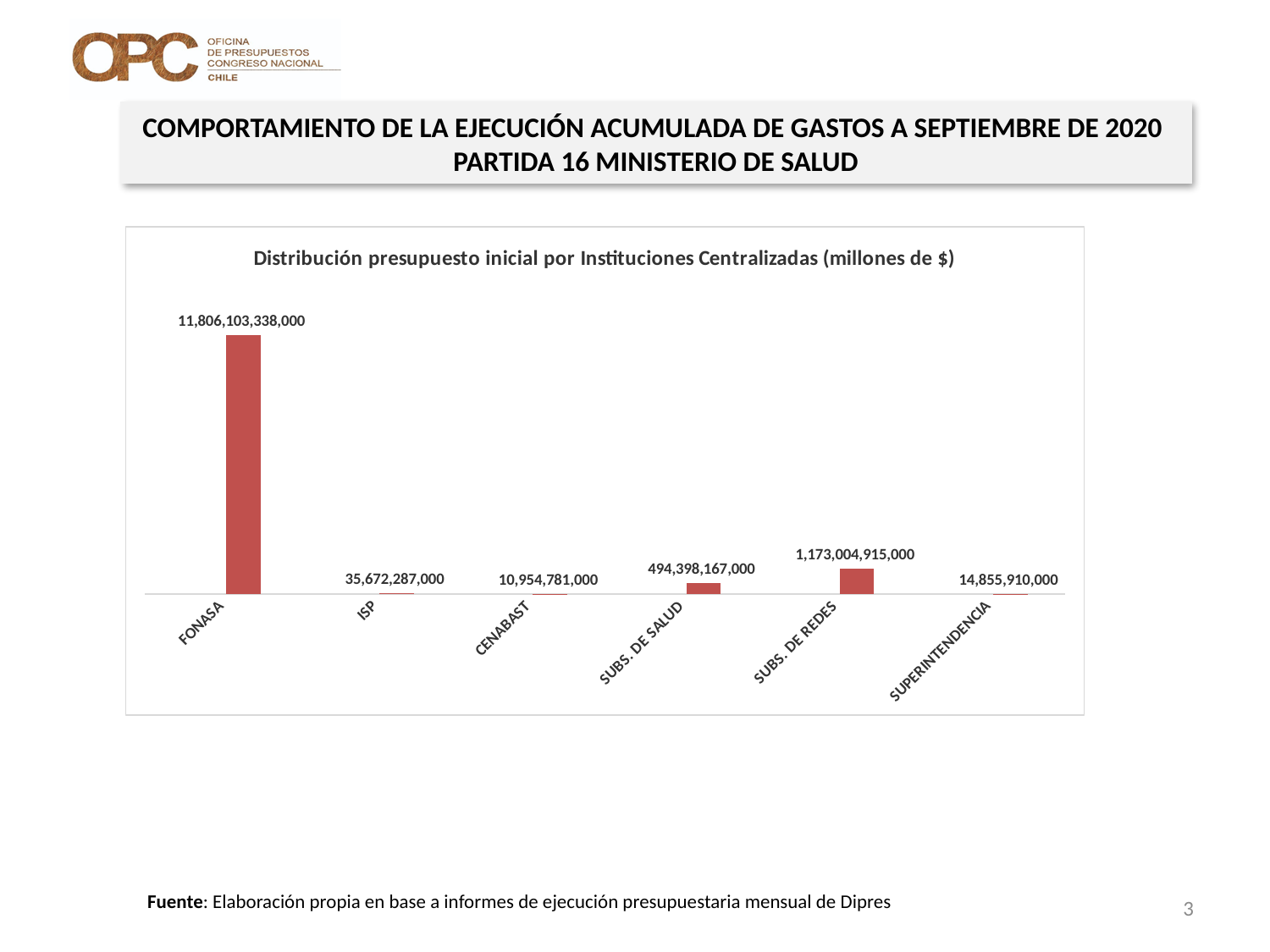
What is the value for SUBS. DE REDES? 1,173,004,915,000 What is the value for ISP? 35,672,287,000 Which is larger, the value for SUBS. DE SALUD or the value for SUBS. DE REDES? SUBS. DE REDES Which institution has the highest value? FONASA What is the value for FONASA? 11,806,103,338,000 How many institutions are shown on the chart? 6 What is the value for SUPERINTENDENCIA? 14,855,910,000 Which institution has the lowest value? CENABAST What is the difference between the values for ISP and CENABAST? 24,717,506,000 What is the title of the chart? Distribución presupuesto inicial por Instituciones Centralizadas (millones de $) What kind of chart is shown on the slide? Bar chart What is the difference between the values for SUBS. DE REDES and SUBS. DE SALUD? 678,606,748,000